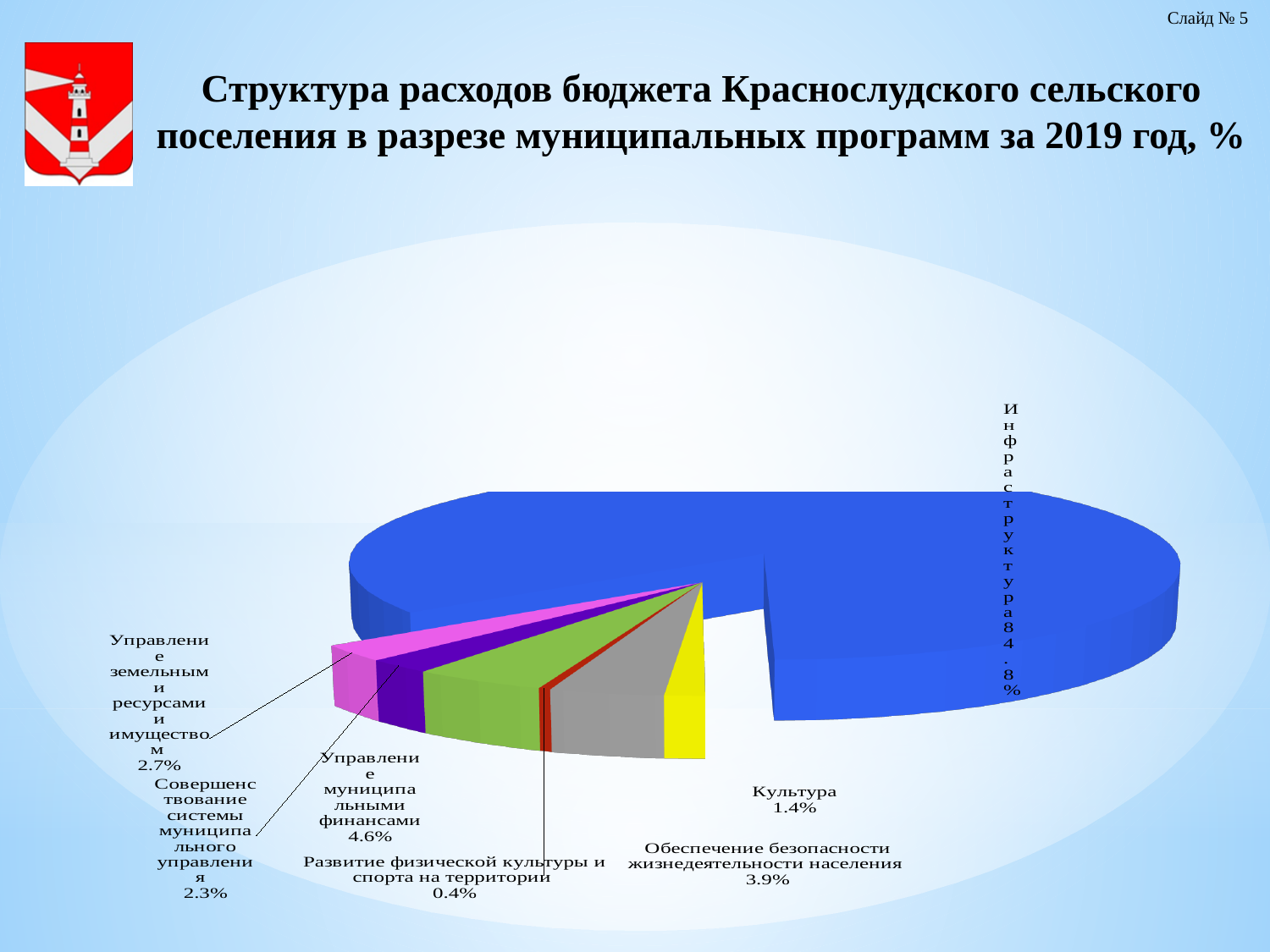
Which category has the largest share of the pie? Инфраструктура What is the value shown for Обеспечение безопасности жизнедеятельности населения? 3.9% Which is larger: Управление земельными ресурсами и имуществом or Совершенствование системы муниципального управления? Управление земельными ресурсами и имуществом What year does the chart title say the expenditure structure refers to? 2019 What is the value shown for Развитие физической культуры и спорта на территории? 0.4% How many slices does the pie chart have? 7 What is the value shown for Управление муниципальными финансами? 4.6% What is the value shown for Культура? 1.4% What kind of chart is shown on the slide? Pie chart What is the difference between the shares of Управление муниципальными финансами and Обеспечение безопасности жизнедеятельности населения? 0.7% Which category has the smallest share of the pie? Развитие физической культуры и спорта на территории What share of budget expenditure does Инфраструктура account for? 84.8%